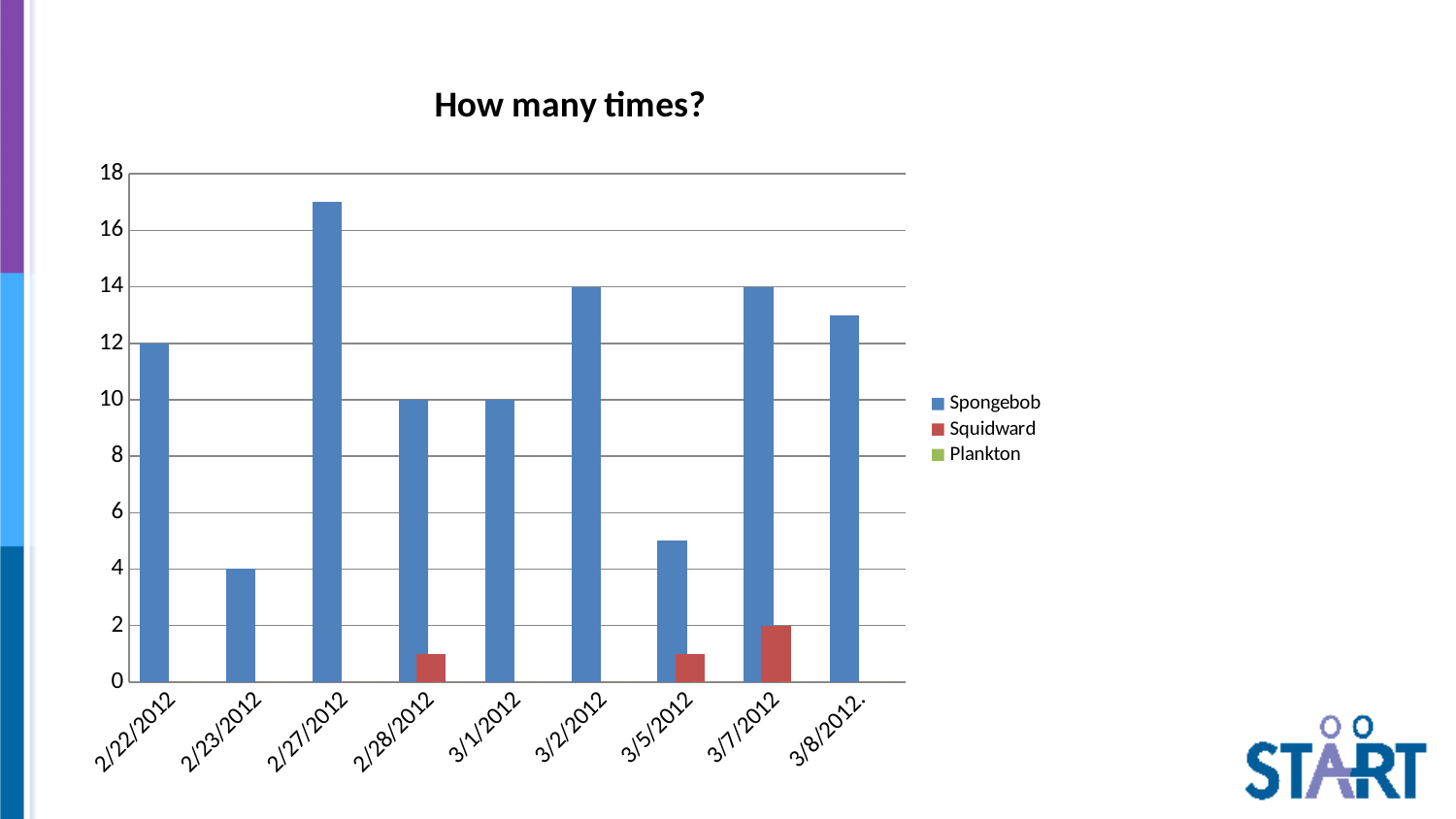
Which has a larger Spongebob value, 3/2/2012 or 2/28/2012? 3/2/2012 What is the Spongebob value for 2/22/2012? 12 Is the Spongebob value for 3/8/2012 greater or less than 12? greater What is the difference between the Spongebob values for 2/22/2012 and 2/23/2012? 8 On which date is the Spongebob value highest? 2/27/2012 How many dates are shown on the x axis? 9 On which date is the Spongebob value lowest? 2/23/2012 What is the Squidward value for 3/7/2012? 2 What is the Spongebob value for 2/23/2012? 4 How many series does the legend list? 3 What is the Spongebob value for 3/2/2012? 14 Is the Spongebob value for 2/27/2012 greater or less than 16? greater